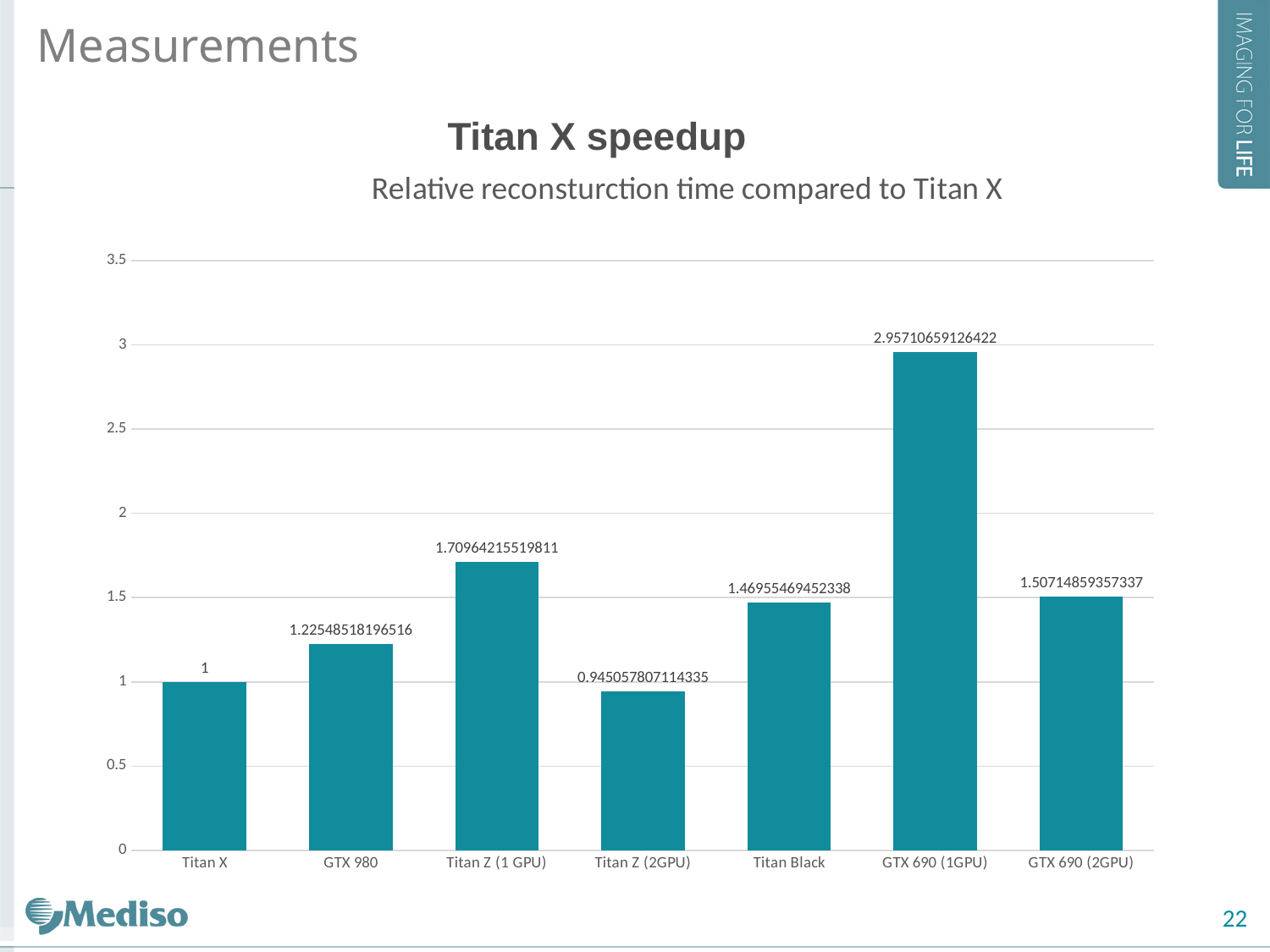
What is the value for GTX 690 (1GPU)? 2.95710659126422 Is the value for GTX 690 (2GPU) greater or less than 1? greater What is the value for Titan Black? 1.46955469452338 Which category has the highest value? GTX 690 (1GPU) What is the difference between the values for GTX 690 (1GPU) and Titan X? 1.95710659126422 What kind of chart is shown on the slide? bar chart What is the value for Titan Z (2GPU)? 0.945057807114335 What is the title of the chart? Relative reconsturction time compared to Titan X How many categories are shown on the x axis? 7 Which category has the lowest value? Titan Z (2GPU) What is the value for GTX 980? 1.22548518196516 Which is larger, the value for Titan Z (1 GPU) or the value for GTX 980? Titan Z (1 GPU)